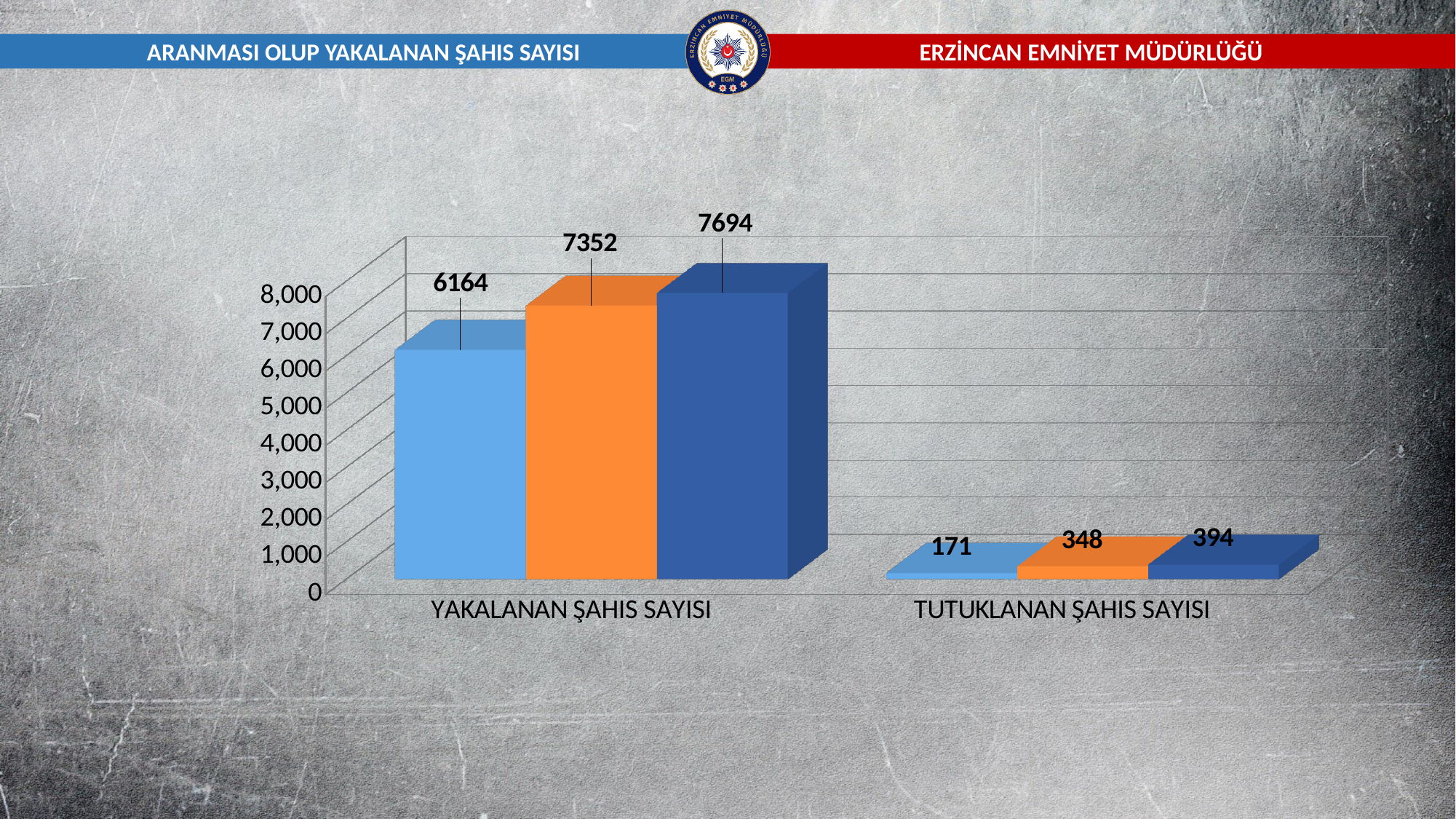
What is the value of the light blue bar for TUTUKLANAN ŞAHIS SAYISI? 171 What is the difference between the dark blue and orange bars for YAKALANAN ŞAHIS SAYISI? 342 What is the value of the dark blue bar for TUTUKLANAN ŞAHIS SAYISI? 394 How many categories are shown on the x axis of the chart? 2 What is the value of the light blue bar for YAKALANAN ŞAHIS SAYISI? 6164 What is the difference between the orange and light blue bars for TUTUKLANAN ŞAHIS SAYISI? 177 Which is larger for YAKALANAN ŞAHIS SAYISI, the light blue bar or the orange bar? the orange bar Which bar has the lowest value in the chart? the light blue bar for TUTUKLANAN ŞAHIS SAYISI (171) What type of chart is shown on the slide? bar chart Which bar has the highest value in the chart? the dark blue bar for YAKALANAN ŞAHIS SAYISI (7694) What is the title shown in the blue banner at the top left of the slide? ARANMASI OLUP YAKALANAN ŞAHIS SAYISI What is the value of the orange bar for YAKALANAN ŞAHIS SAYISI? 7352